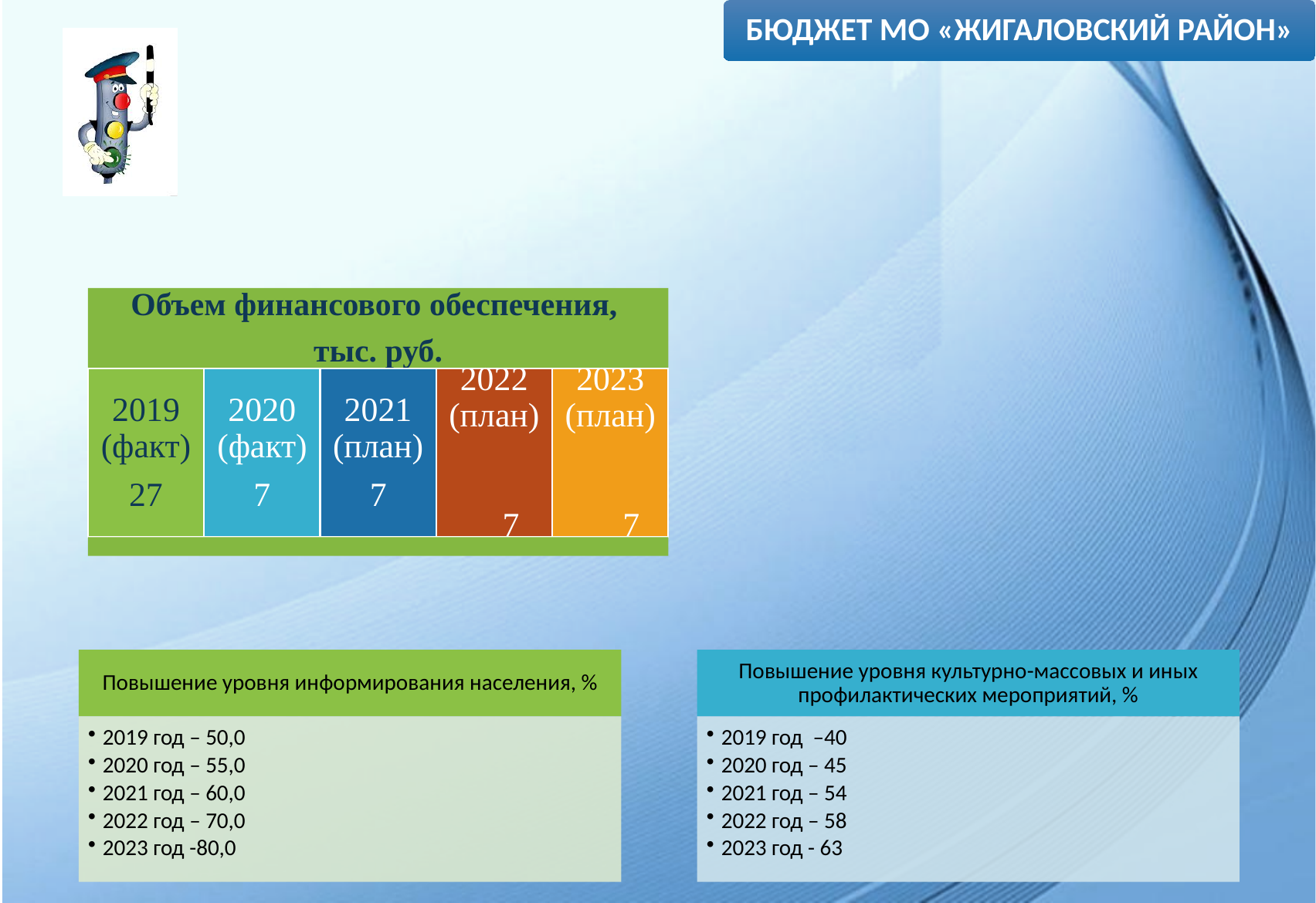
What is the value for 2019 (факт) in the 'Объем финансового обеспечения, тыс. руб.' chart? 27 What is the value for 2020 (факт) in the 'Объем финансового обеспечения, тыс. руб.' chart? 7 What is the title of the chart on the left side of the slide? Объем финансового обеспечения, тыс. руб. In the 'Объем финансового обеспечения, тыс. руб.' chart, which is larger: the value for 2019 (факт) or the value for 2022 (план)? 2019 (факт) What is the difference between the 2019 (факт) and 2020 (факт) values in the 'Объем финансового обеспечения, тыс. руб.' chart? 20 What is the value for 2021 (план) in the 'Объем финансового обеспечения, тыс. руб.' chart? 7 What colour is the 2021 (план) column in the 'Объем финансового обеспечения, тыс. руб.' chart? blue What is the total of the values for 2020 (факт), 2021 (план), 2022 (план) and 2023 (план) in the 'Объем финансового обеспечения, тыс. руб.' chart? 28 Do the values in the 'Объем финансового обеспечения, тыс. руб.' chart rise or fall from 2019 to 2020? fall Which year has the highest value in the 'Объем финансового обеспечения, тыс. руб.' chart? 2019 (факт) What is the value for 2023 (план) in the 'Объем финансового обеспечения, тыс. руб.' chart? 7 How many years are shown in the 'Объем финансового обеспечения, тыс. руб.' chart? 5